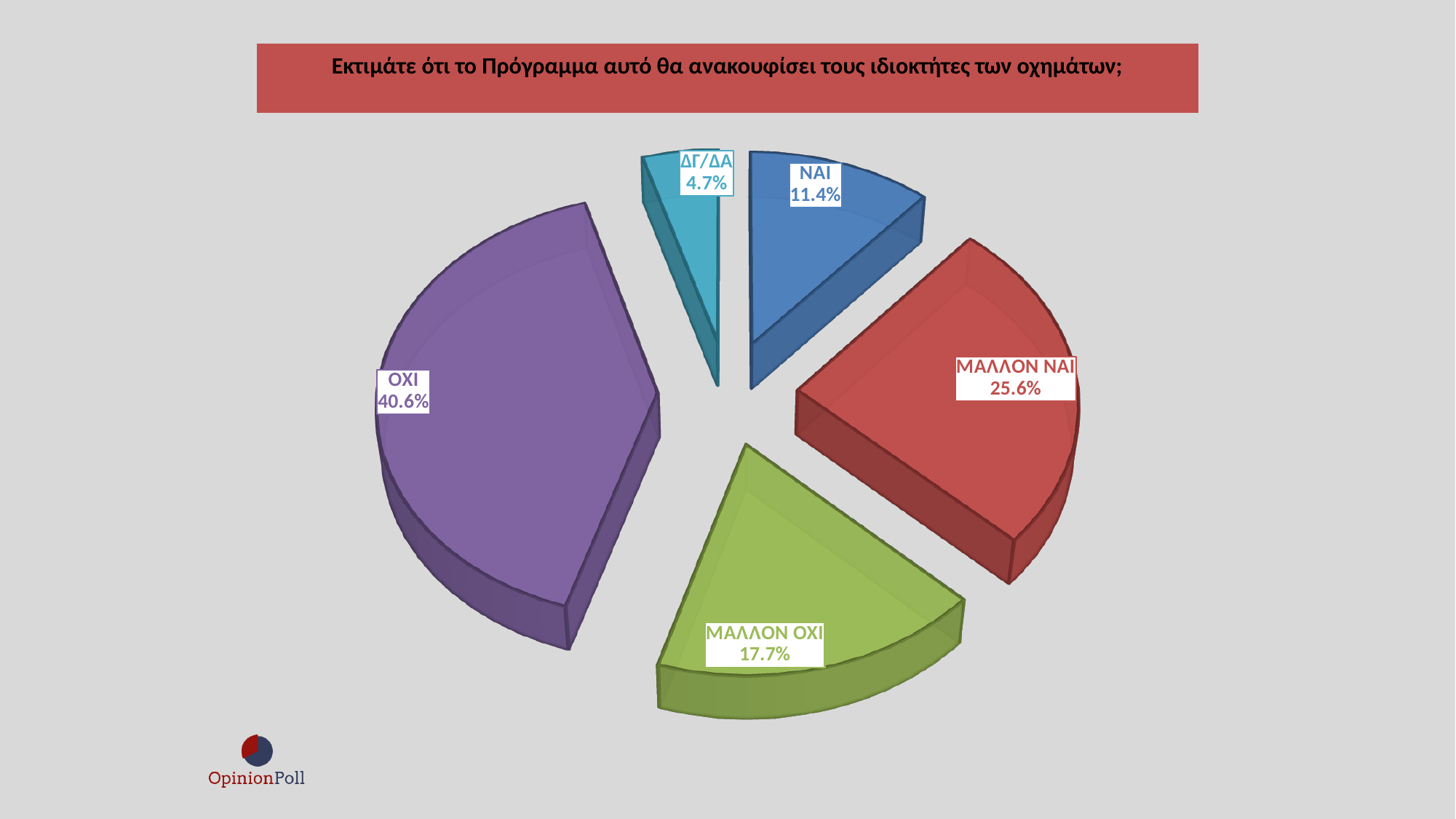
How many slices does the pie chart have? 5 What colour is the ΟΧΙ slice? purple What is the value for ΔΓ/ΔΑ? 4.7% Which category has the smallest share of the pie? ΔΓ/ΔΑ What type of chart is shown on the slide? pie chart Which is larger, the value for ΜΑΛΛΟΝ ΟΧΙ or the value for ΝΑΙ? ΜΑΛΛΟΝ ΟΧΙ What is the value for ΜΑΛΛΟΝ ΝΑΙ? 25.6% What is the difference between the values for ΟΧΙ and ΜΑΛΛΟΝ ΝΑΙ? 15.0% What is the value for ΟΧΙ? 40.6% Which category has the largest share of the pie? ΟΧΙ What is the value for ΝΑΙ? 11.4% What is the value for ΜΑΛΛΟΝ ΟΧΙ? 17.7%